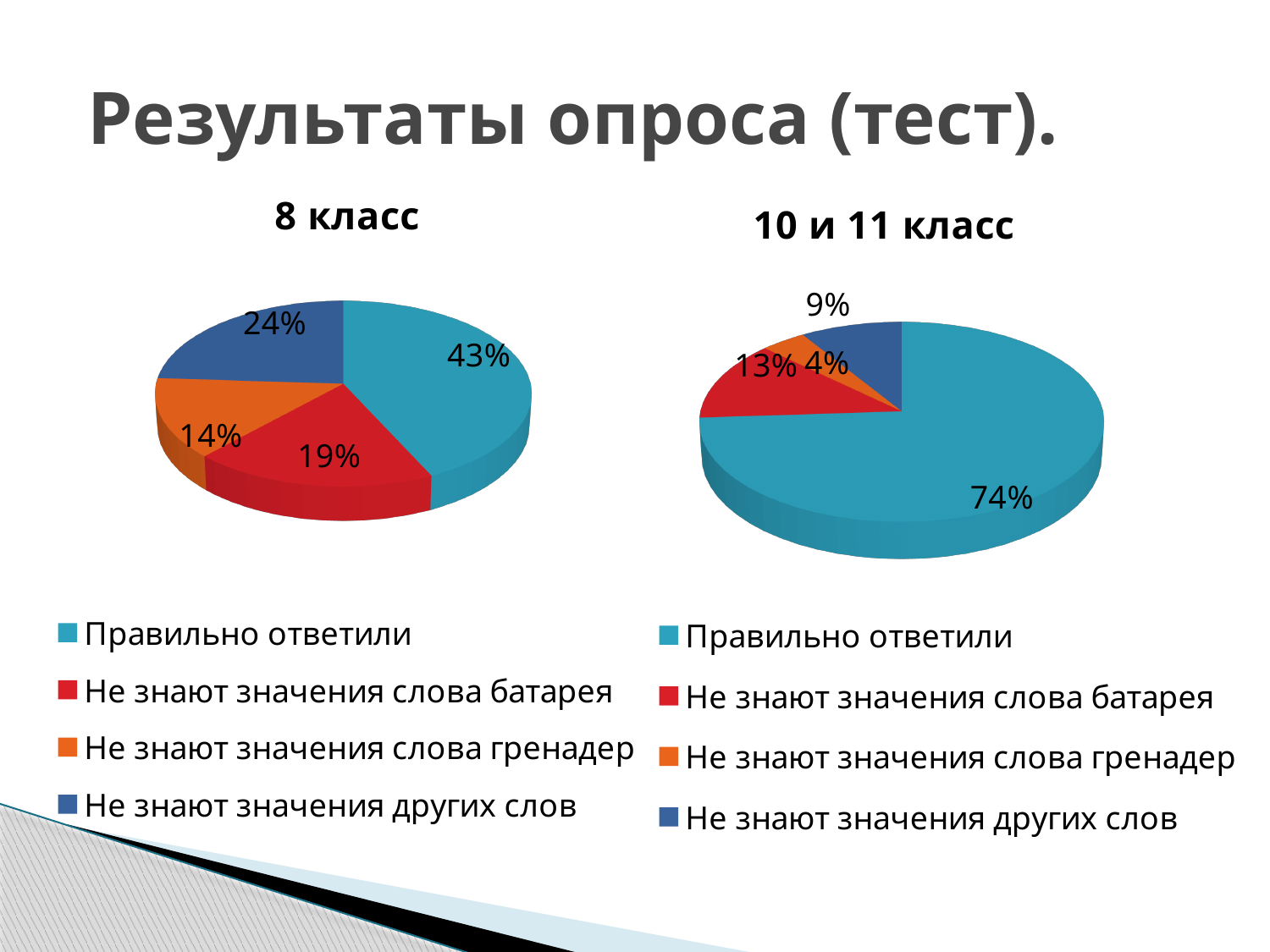
In the "8 класс" chart, what is the value for "Не знают значения других слов"? 24% In the "8 класс" chart, what share of the pie is "Правильно ответили"? 43% In the "8 класс" chart, what colour is the slice for "Не знают значения слова гренадер"? Orange What type of chart is the "8 класс" chart? Pie chart In the "10 и 11 класс" chart, what is the difference between "Не знают значения слова батарея" and "Не знают значения других слов"? 4% In the "8 класс" chart, what is the difference between "Правильно ответили" and "Не знают значения слова батарея"? 24% In the "10 и 11 класс" chart, which category has the largest slice? Правильно ответили In the "8 класс" chart, which is larger: "Не знают значения других слов" or "Не знают значения слова батарея"? Не знают значения других слов In the "10 и 11 класс" chart, what is the value for "Не знают значения слова гренадер"? 4% In the "10 и 11 класс" chart, what share of the pie is "Правильно ответили"? 74% How many slices does the "10 и 11 класс" pie chart have? 4 In the "8 класс" chart, which category has the smallest slice? Не знают значения слова гренадер